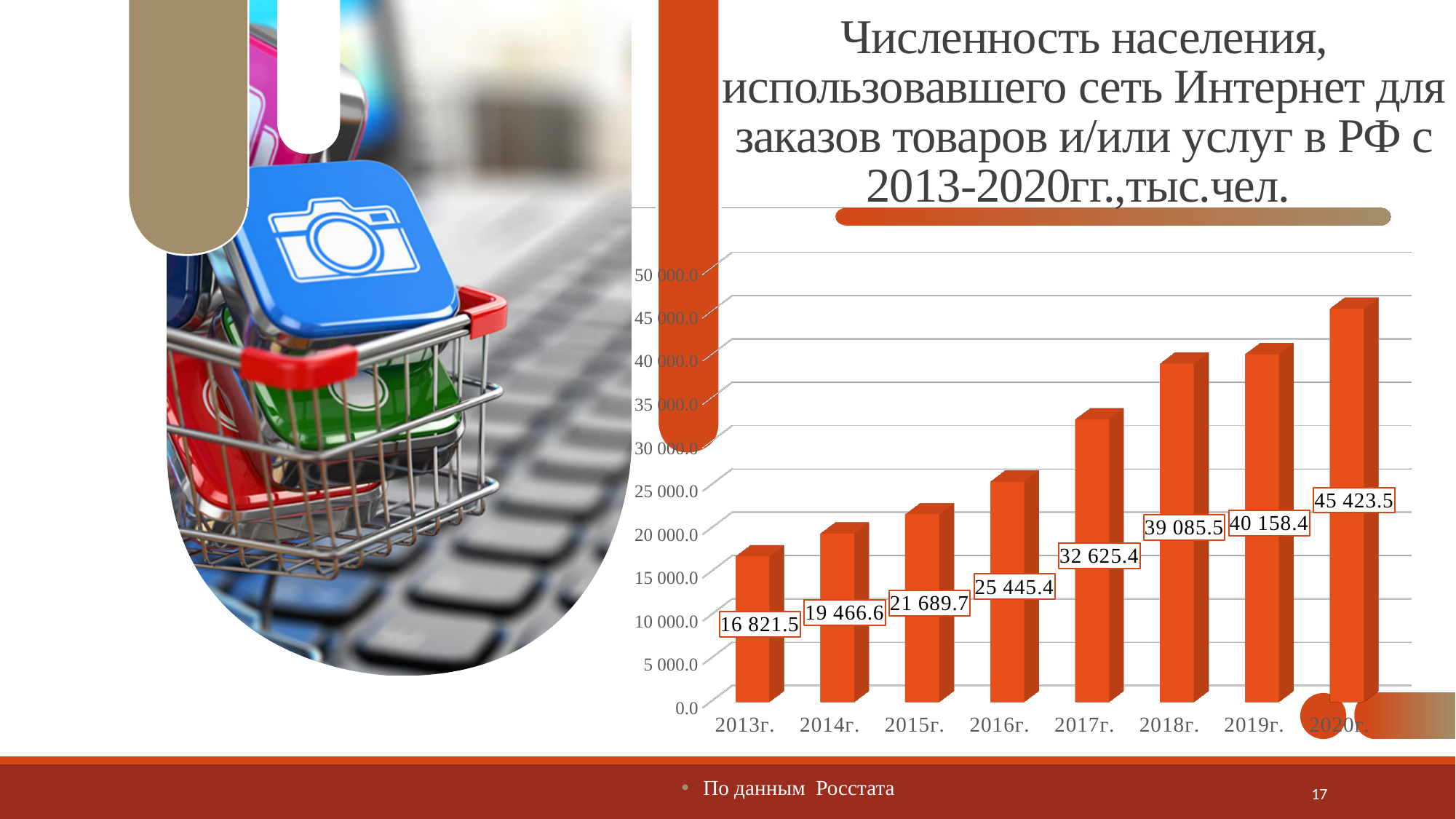
What is the value for 2020г.? 45 423.5 Which is larger, the value for 2015г. or the value for 2016г.? 2016г. What is the difference between the values for 2020г. and 2013г.? 28 602.0 Do the values rise or fall from 2013г. to 2020г.? Rise What is the difference between the values for 2017г. and 2016г.? 7 180.0 Which year has the highest value? 2020г. What type of chart is shown on the slide? Bar chart Is the value for 2018г. greater or less than 35 000.0? greater Which year has the lowest value? 2013г. How many years are shown on the x axis? 8 What is the value for 2013г.? 16 821.5 What is the value for 2017г.? 32 625.4